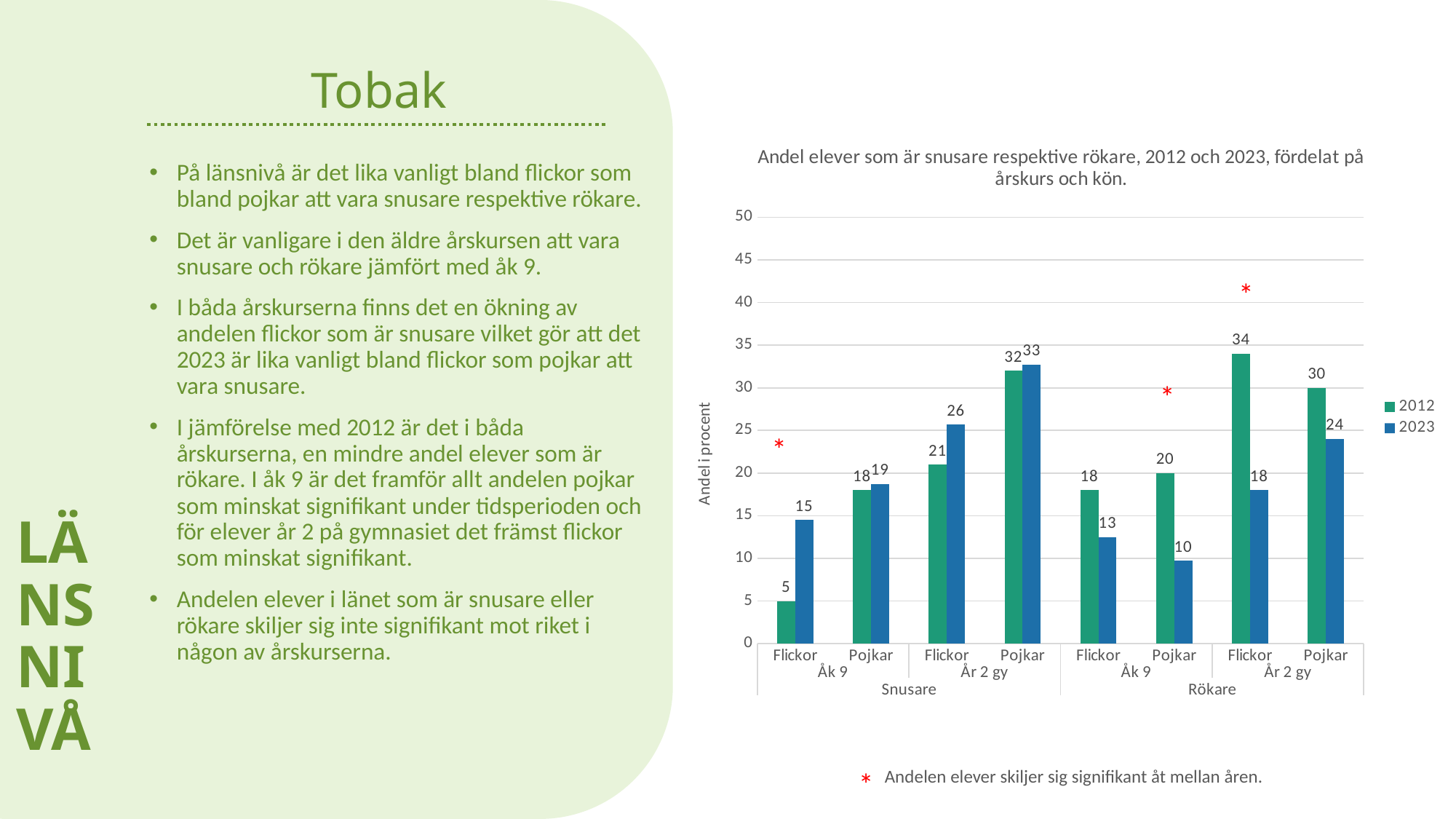
What is the 2023 value for Pojkar in År 2 gy under Rökare? 24 How many category groups (Flickor/Pojkar pairs) are shown along the x axis? 4 Which bar has the lowest value in the chart? Flickor, Åk 9, Snusare, 2012 (5) What is the 2023 value for Flickor in År 2 gy under Snusare? 26 What is the difference between the 2012 and 2023 values for Flickor in År 2 gy under Rökare? 16 What is the label of the y axis? Andel i procent Which bar has the highest value in the chart? Flickor, År 2 gy, Rökare, 2012 (34) What is the 2012 value for Flickor in Åk 9 under Snusare? 5 What is the difference between the 2023 and 2012 values for Flickor in Åk 9 under Snusare? 10 How many series does the legend list? 2 What kind of chart is shown on the slide? Bar chart Which is larger for Pojkar in Åk 9 under Rökare: the 2012 value or the 2023 value? 2012